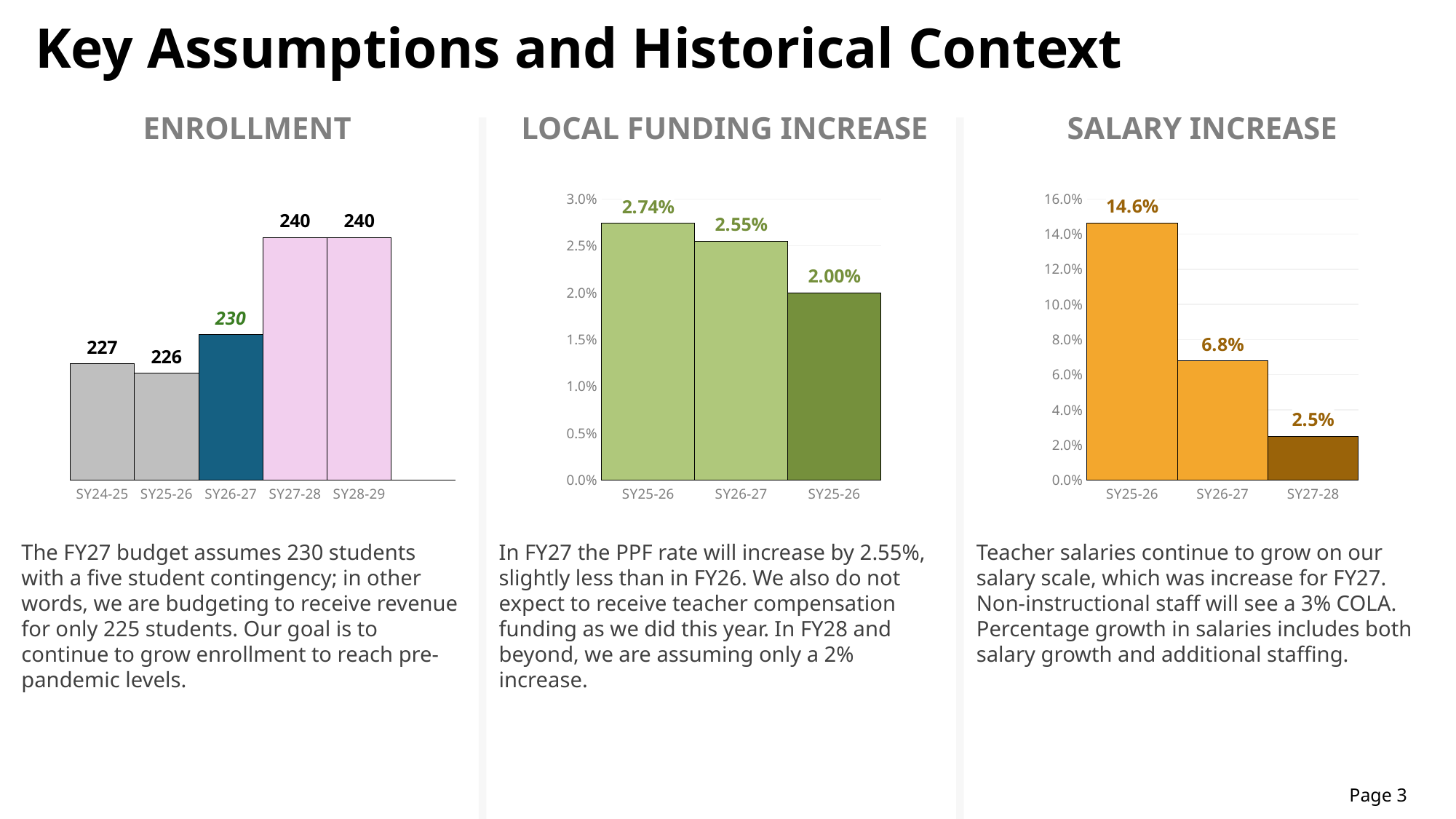
In the Local Funding Increase chart, what is the value for SY26-27? 2.55% In the Enrollment chart, what is the difference between the SY27-28 value and the SY26-27 value? 10 In the Enrollment chart, what is the value for SY24-25? 227 In the Local Funding Increase chart, what is the value of the first (leftmost) bar? 2.74% In the Salary Increase chart, which category has the highest value? SY25-26 In the Enrollment chart, which category has the lowest value? SY25-26 In the Local Funding Increase chart, do the values rise or fall from left to right? fall In the Salary Increase chart, what is the value for SY25-26? 14.6% What type of chart is the Salary Increase chart? bar chart In the Enrollment chart, how many bars are plotted? 5 In the Salary Increase chart, what is the difference between the SY26-27 value and the SY27-28 value? 4.3% In the Enrollment chart, what is the value for SY26-27? 230